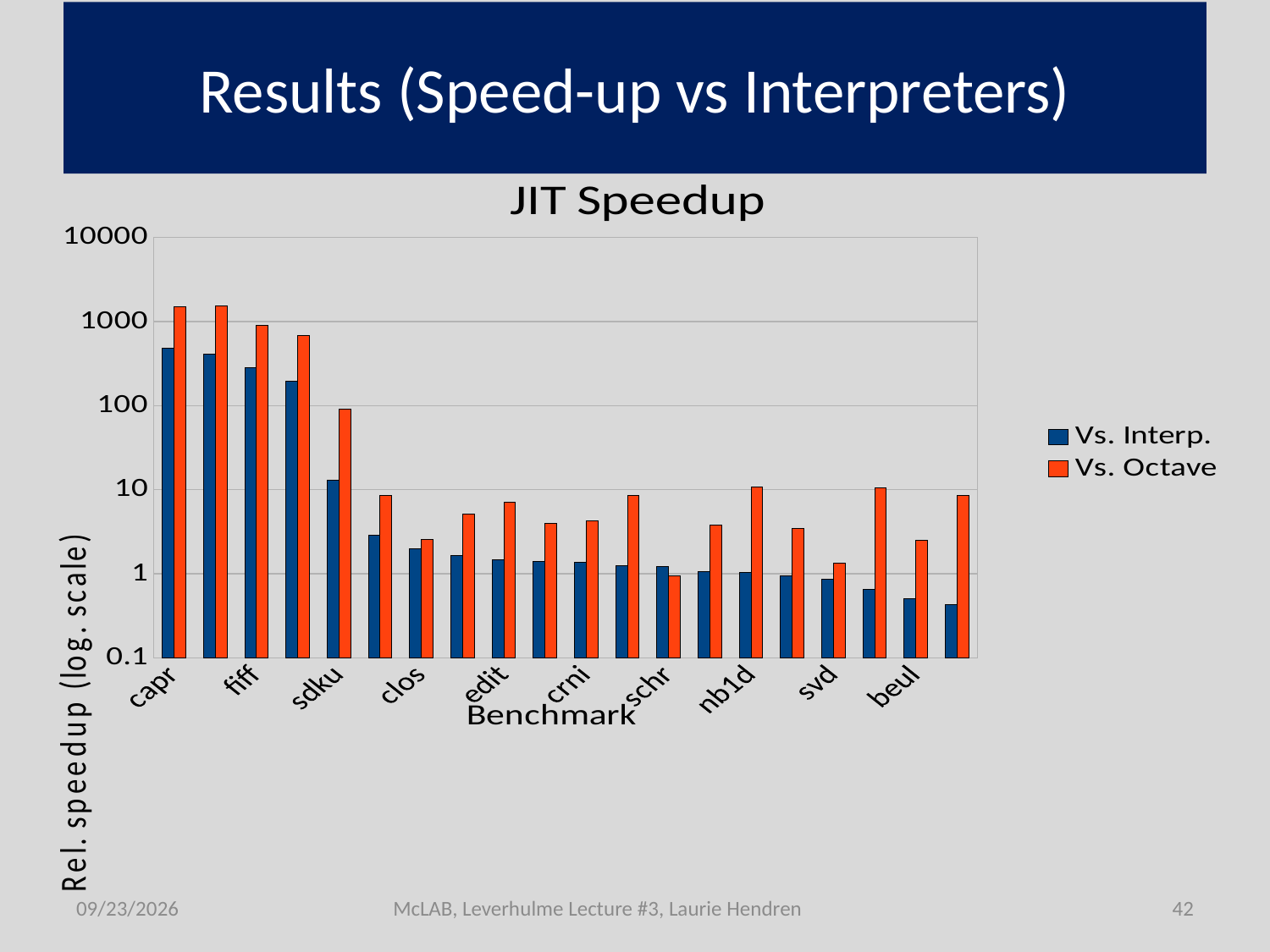
Is the Vs. Interp. value for capr greater or less than 1000? less Is the Vs. Octave value for edit greater or less than 10? less What is the label of the y axis? Rel. speedup (log. scale) For capr, which is larger: the Vs. Interp. value or the Vs. Octave value? Vs. Octave What is the title of the chart? JIT Speedup Do the Vs. Interp. values generally rise or fall from left to right along the x axis? fall Is the Vs. Octave value for capr greater or less than 1000? greater How many series does the legend list? 2 What kind of chart is shown on the slide? bar chart